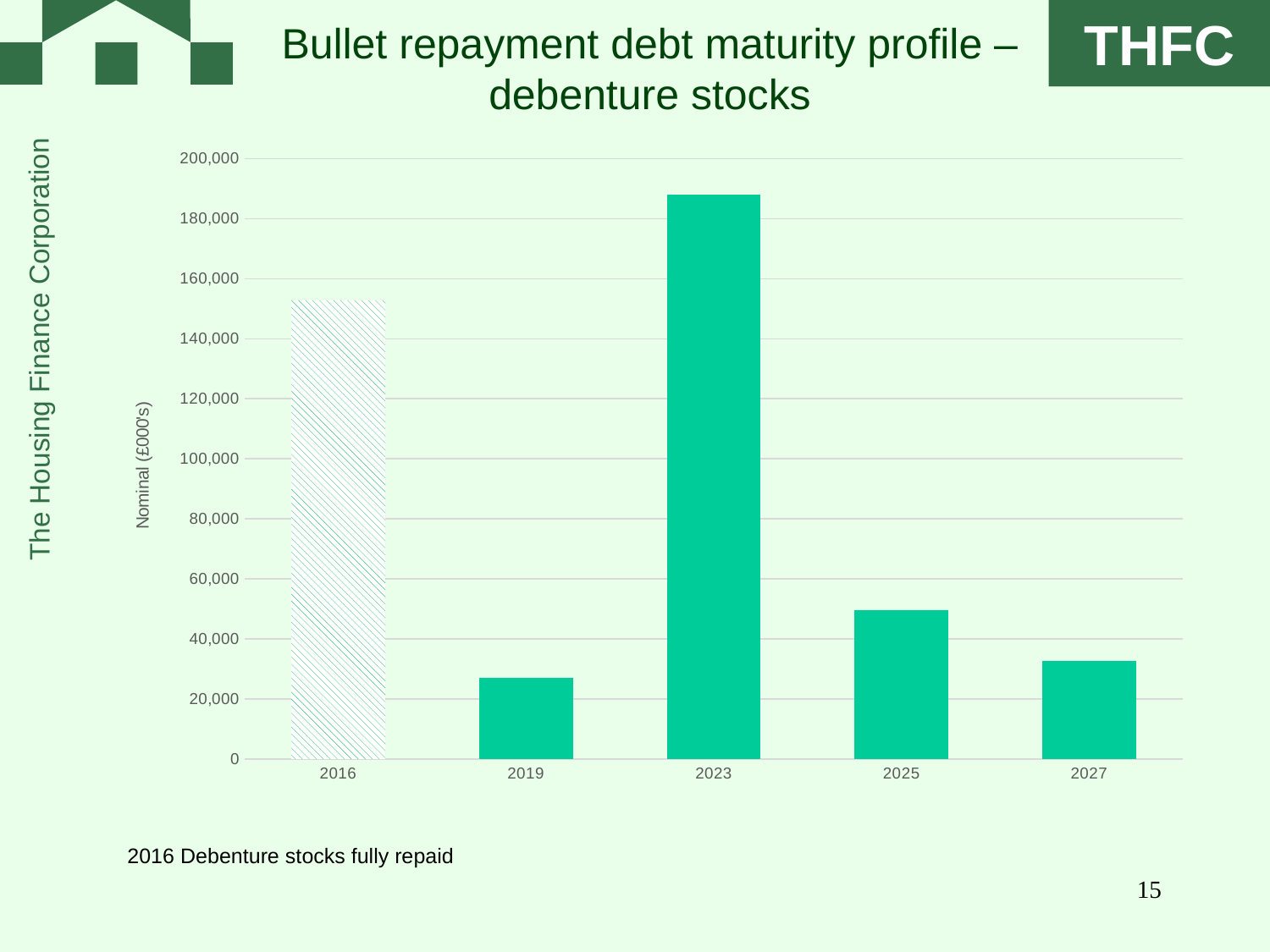
Is the value for 2019 greater or less than 40,000? less How many years are shown on the x axis of the chart? 5 Which is larger, the value for 2025 or the value for 2027? 2025 What is the label on the vertical axis of the chart? Nominal (£000's) What kind of chart is shown on the slide? bar chart Which year has the highest bar in the chart? 2023 Which is larger, the value for 2023 or the value for 2016? 2023 Is the value for 2023 greater or less than 180,000? greater Is the value for 2016 greater or less than 140,000? greater Which year has the lowest bar in the chart? 2019